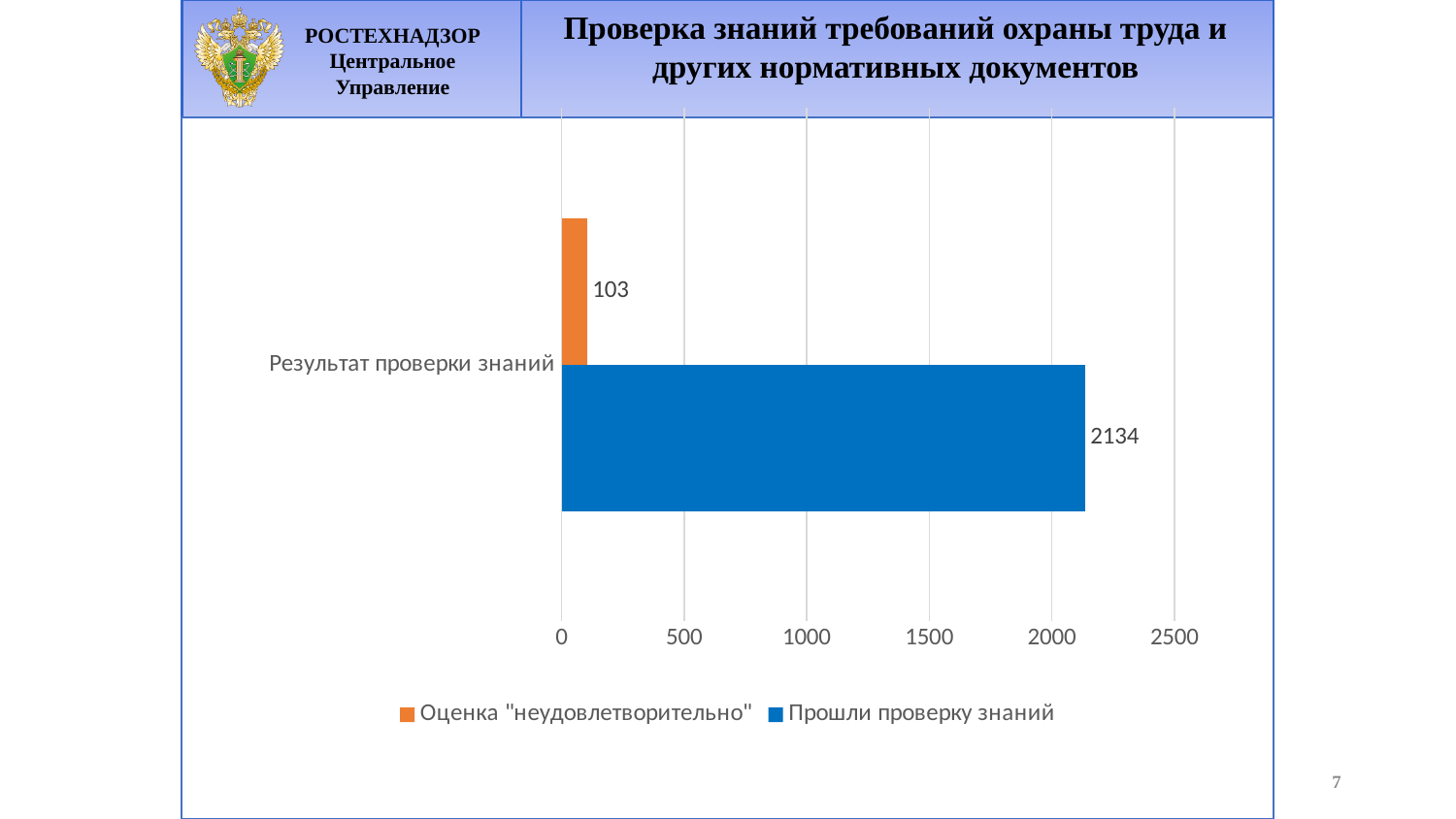
What colour is the bar for "Прошли проверку знаний"? Blue What kind of chart is shown on the slide? Bar chart How many categories are shown on the category axis? 1 What is the value for "Оценка "неудовлетворительно""? 103 What is the value for "Прошли проверку знаний"? 2134 What is the label of the category on the chart? Результат проверки знаний Is the value for "Прошли проверку знаний" greater or less than 2000? greater Is the value for "Оценка "неудовлетворительно"" greater or less than 500? less What is the difference between the values for "Прошли проверку знаний" and "Оценка "неудовлетворительно""? 2031 Which series has the higher value, "Прошли проверку знаний" or "Оценка "неудовлетворительно""? Прошли проверку знаний What is the highest value shown on the value axis? 2500 How many series does the legend list? 2